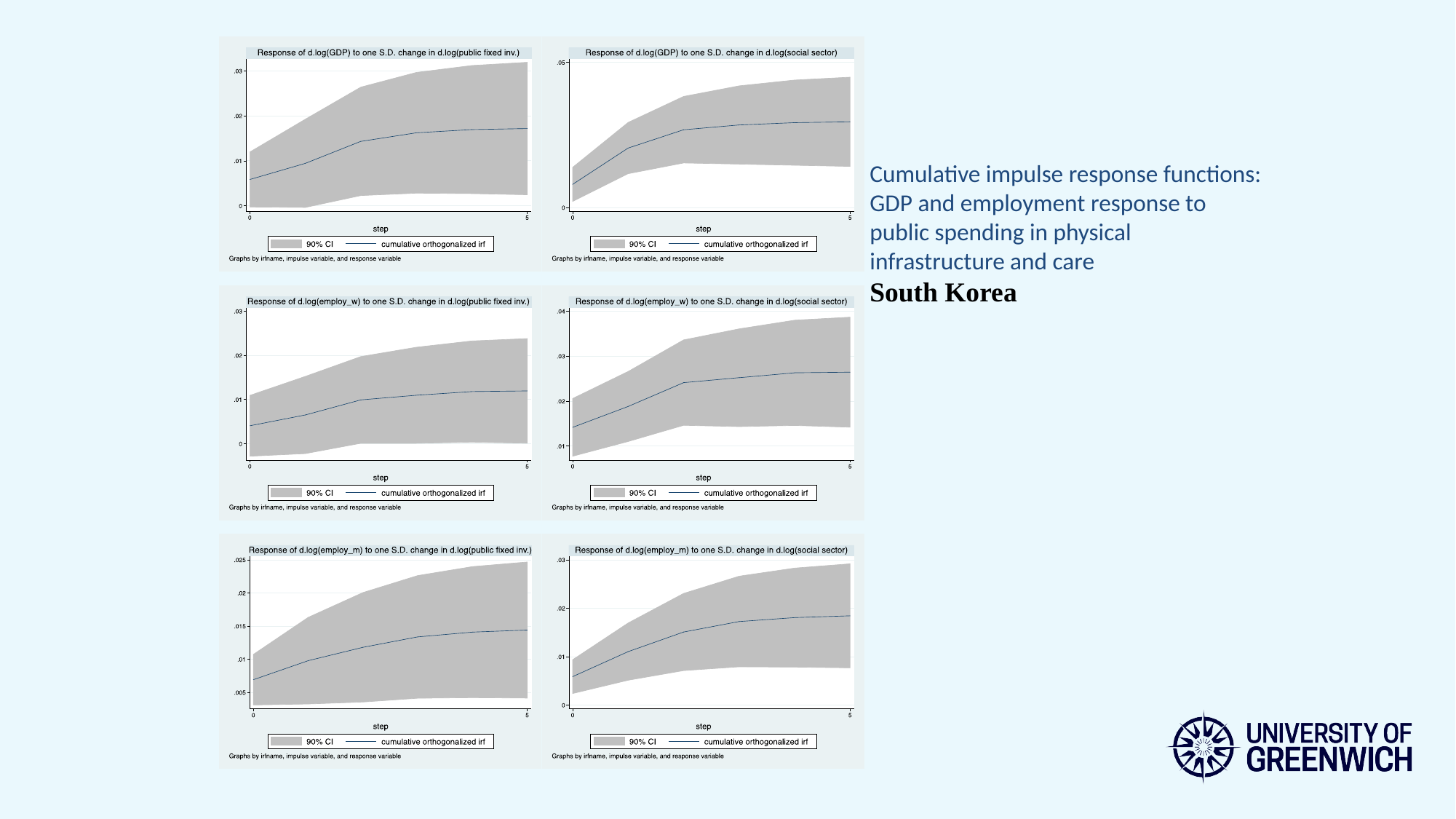
In the middle-left chart (employ_w response to public fixed inv.), is the value of the cumulative orthogonalized irf at step 0 greater or less than .01? less In the top-left chart (GDP response to public fixed inv.), how many entries does the legend list? 2 In the bottom-left chart (employ_m response to public fixed inv.), is the value of the cumulative orthogonalized irf at step 5 greater or less than .01? greater How many charts are shown on the slide? 6 In the middle-right chart (employ_w response to social sector), is the value of the cumulative orthogonalized irf at step 5 greater or less than .03? less In the top-left chart (GDP response to public fixed inv.), does the cumulative orthogonalized irf line rise or fall as step increases from 0 to 5? Rise In the bottom-right chart (employ_m response to social sector), does the cumulative orthogonalized irf line rise or fall as step increases from 0 to 5? Rise What kind of chart is the top-left chart, 'Response of d.log(GDP) to one S.D. change in d.log(public fixed inv.)'? Line chart What confidence level does the shaded band in the legend of the bottom-right chart (employ_m response to social sector) represent? 90% CI What is the x-axis label of the middle-right chart (employ_w response to social sector)? step